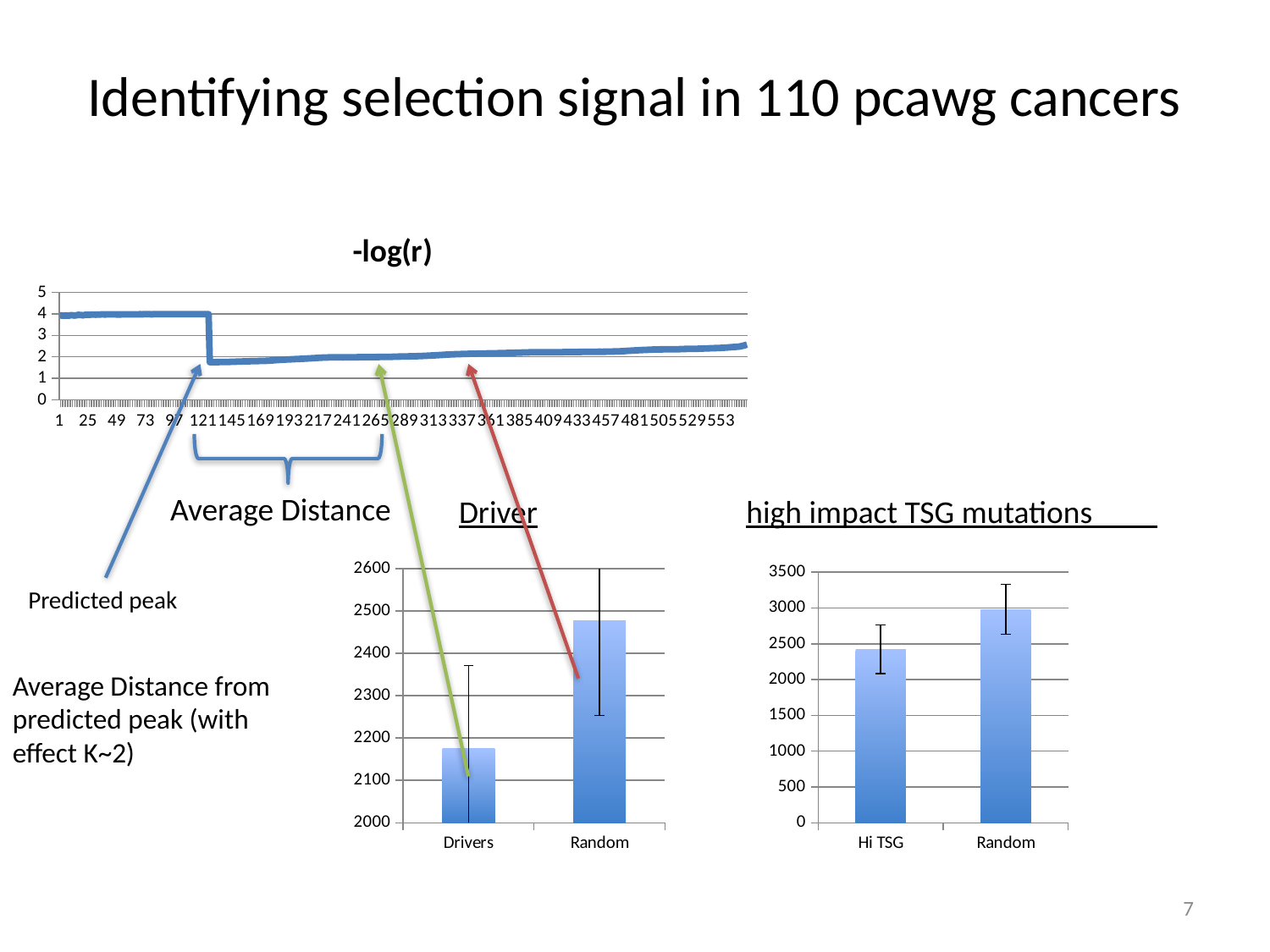
In the "Driver" chart, is the value for Random greater or less than 2400? greater In the "-log(r)" chart, is the value at the far right end of the x axis greater or less than 3? less What is the highest tick value shown on the y axis of the "high impact TSG mutations" chart? 3500 In the "high impact TSG mutations" chart, which category has the highest value? Random In the "high impact TSG mutations" chart, is the value for Hi TSG greater or less than 2500? less How many categories are shown on the x axis of the "Driver" chart? 2 In the "Driver" chart, which bar is taller, Drivers or Random? Random What kind of chart is the "Driver" chart at the bottom centre of the slide? bar chart What kind of chart is the chart titled "-log(r)"? line chart